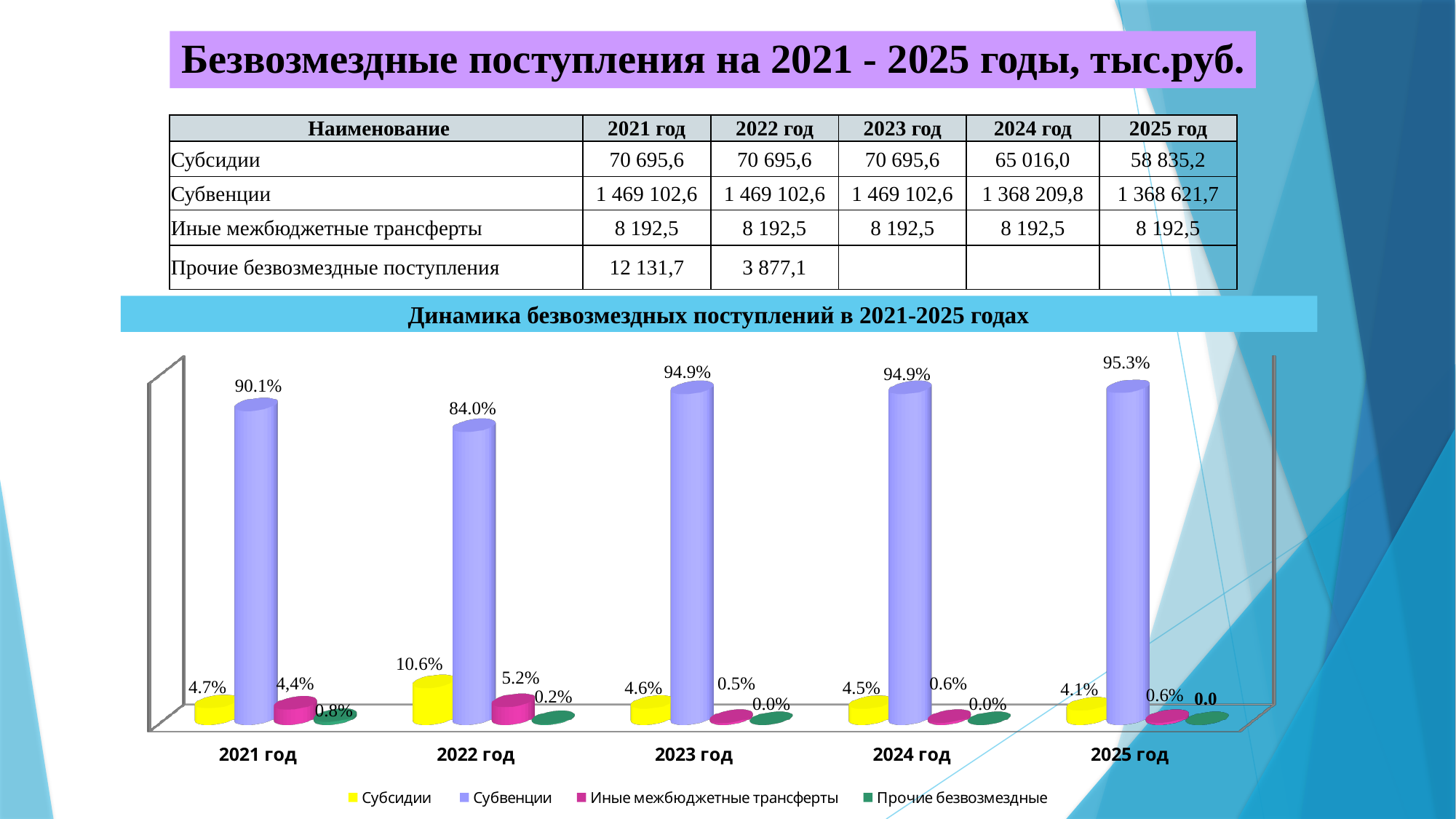
What kind of chart is shown on the slide? Bar chart Which is larger: Субсидии in 2021 год or Субсидии in 2022 год? Субсидии in 2022 год What is the value for Субсидии in 2022 год? 10.6% What is the value for Иные межбюджетные трансферты in 2022 год? 5.2% How many series does the chart legend list? 4 What is the difference between the Субвенции values for 2023 год and 2022 год? 10.9% What is the value for Субвенции in 2021 год? 90.1% In which year is the value for Субвенции highest? 2025 год What is the value for Прочие безвозмездные in 2021 год? 0.8% How many years are shown on the x axis of the chart? 5 What is the title of the chart? Динамика безвозмездных поступлений в 2021-2025 годах In which year is the value for Субсидии lowest? 2025 год